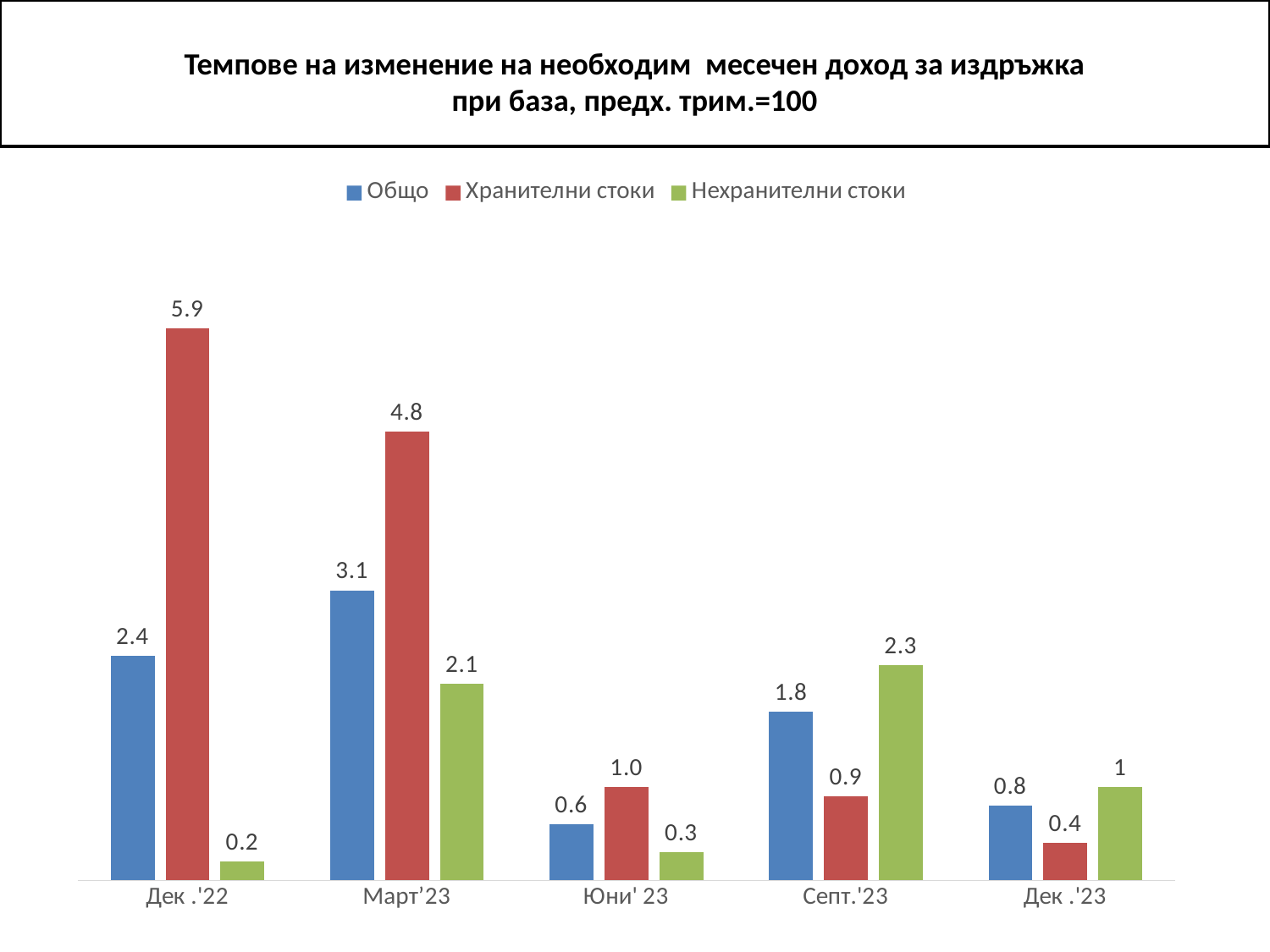
What is the value for Нехранителни стоки in Дек.'23? 1 In which period is the value for Нехранителни стоки the lowest? Дек.'22 How many periods are shown on the x axis? 5 Which is larger in Септ.'23: Общо or Хранителни стоки? Общо What kind of chart is shown on the slide? Bar chart In which period is the value for Хранителни стоки the highest? Дек.'22 What is the difference between Хранителни стоки and Нехранителни стоки in Март'23? 2.7 Which colour represents Хранителни стоки in the chart? Red What is the value for Нехранителни стоки in Септ.'23? 2.3 What is the value for Общо in Март'23? 3.1 What is the value for Хранителни стоки in Дек.'22? 5.9 How many series does the legend list? 3